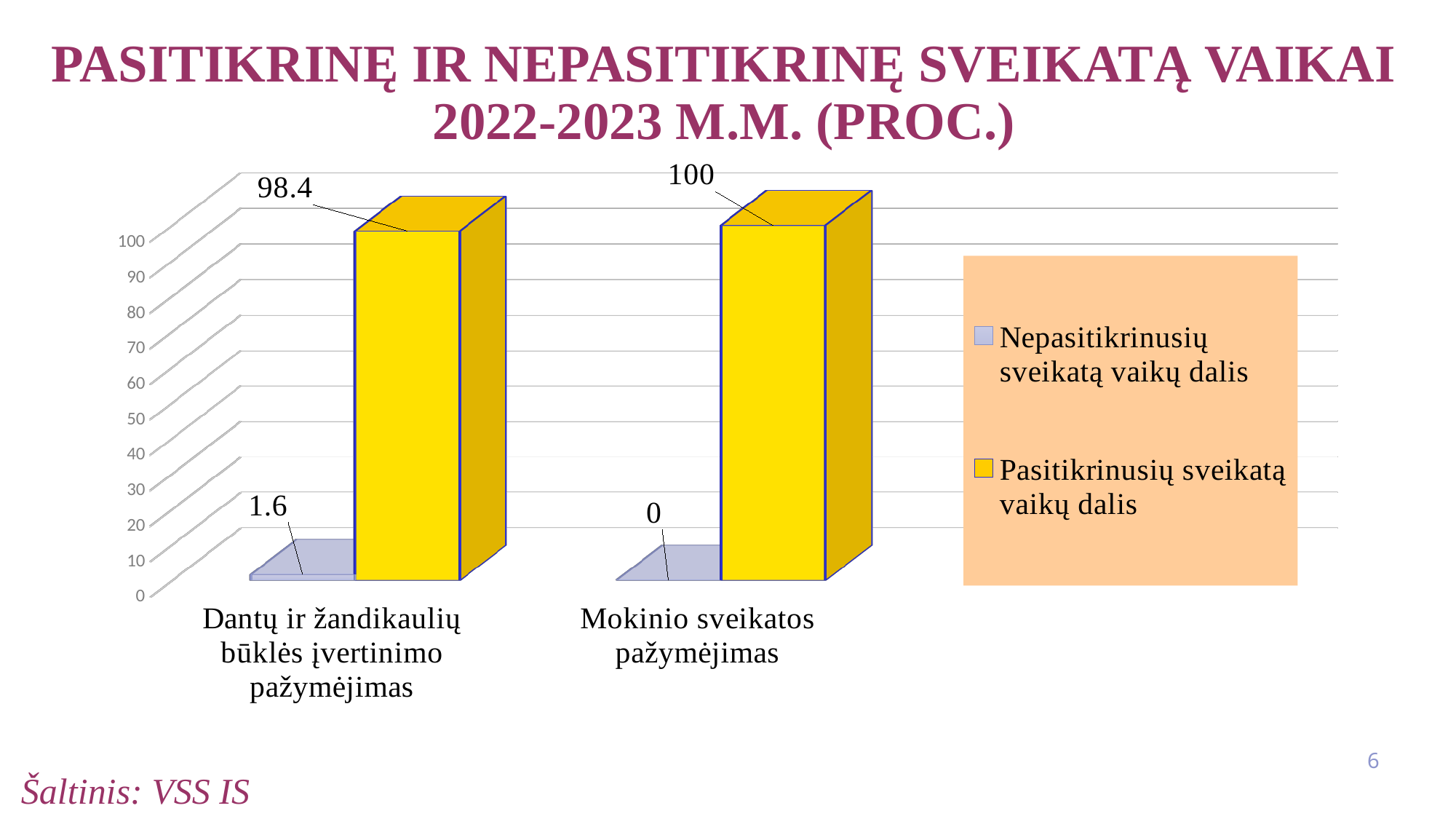
For 'Dantų ir žandikaulių būklės įvertinimo pažymėjimas', which series has the larger value: 'Nepasitikrinusių sveikatą vaikų dalis' or 'Pasitikrinusių sveikatą vaikų dalis'? Pasitikrinusių sveikatą vaikų dalis How many categories are shown on the x axis of the chart? 2 What is the value of 'Pasitikrinusių sveikatą vaikų dalis' for 'Dantų ir žandikaulių būklės įvertinimo pažymėjimas'? 98.4 How many series does the legend list? 2 What colour represents 'Pasitikrinusių sveikatą vaikų dalis' in the chart? Yellow Which category has the lower value for 'Nepasitikrinusių sveikatą vaikų dalis'? Mokinio sveikatos pažymėjimas What is the value of 'Pasitikrinusių sveikatą vaikų dalis' for 'Mokinio sveikatos pažymėjimas'? 100 What is the difference between the 'Pasitikrinusių sveikatą vaikų dalis' values for 'Mokinio sveikatos pažymėjimas' and 'Dantų ir žandikaulių būklės įvertinimo pažymėjimas'? 1.6 What is the value of 'Nepasitikrinusių sveikatą vaikų dalis' for 'Mokinio sveikatos pažymėjimas'? 0 Which category has the higher value for 'Pasitikrinusių sveikatą vaikų dalis'? Mokinio sveikatos pažymėjimas What is the value of 'Nepasitikrinusių sveikatą vaikų dalis' for 'Dantų ir žandikaulių būklės įvertinimo pažymėjimas'? 1.6 What kind of chart is shown on the slide? Bar chart